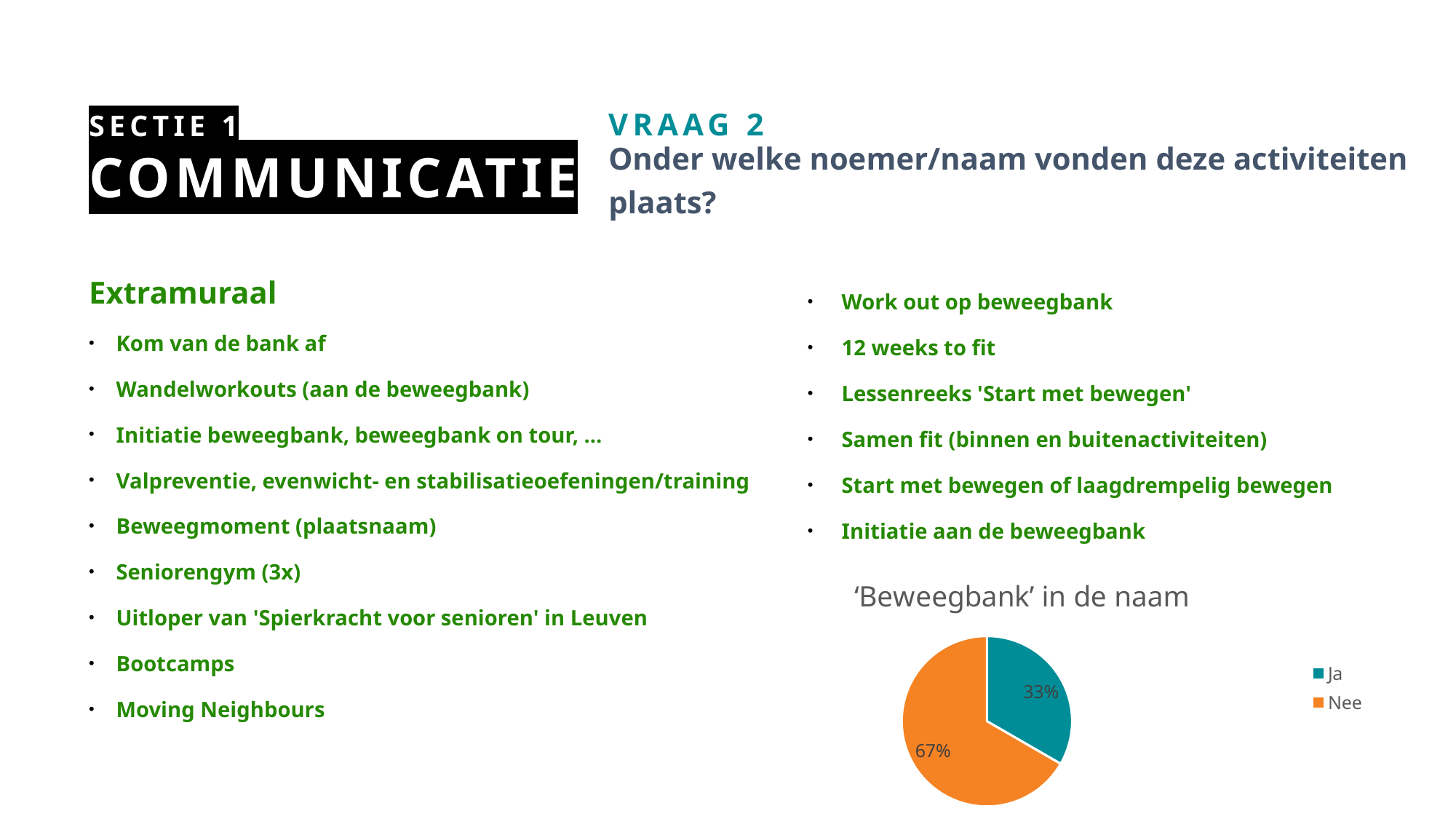
What share of the pie does 'Ja' represent? 33% What share of the pie does 'Nee' represent? 67% Which category has the smallest slice of the pie? Ja What colour is the 'Nee' slice in the pie chart? orange How many entries does the legend list? 2 Which category has the largest slice of the pie? Nee Which is larger, the slice for 'Ja' or the slice for 'Nee'? Nee What is the difference in percentage points between the 'Nee' and 'Ja' slices? 34 What is the title of the pie chart? ‘Beweegbank’ in de naam What kind of chart is shown on the slide? pie chart How many categories does the pie chart have? 2